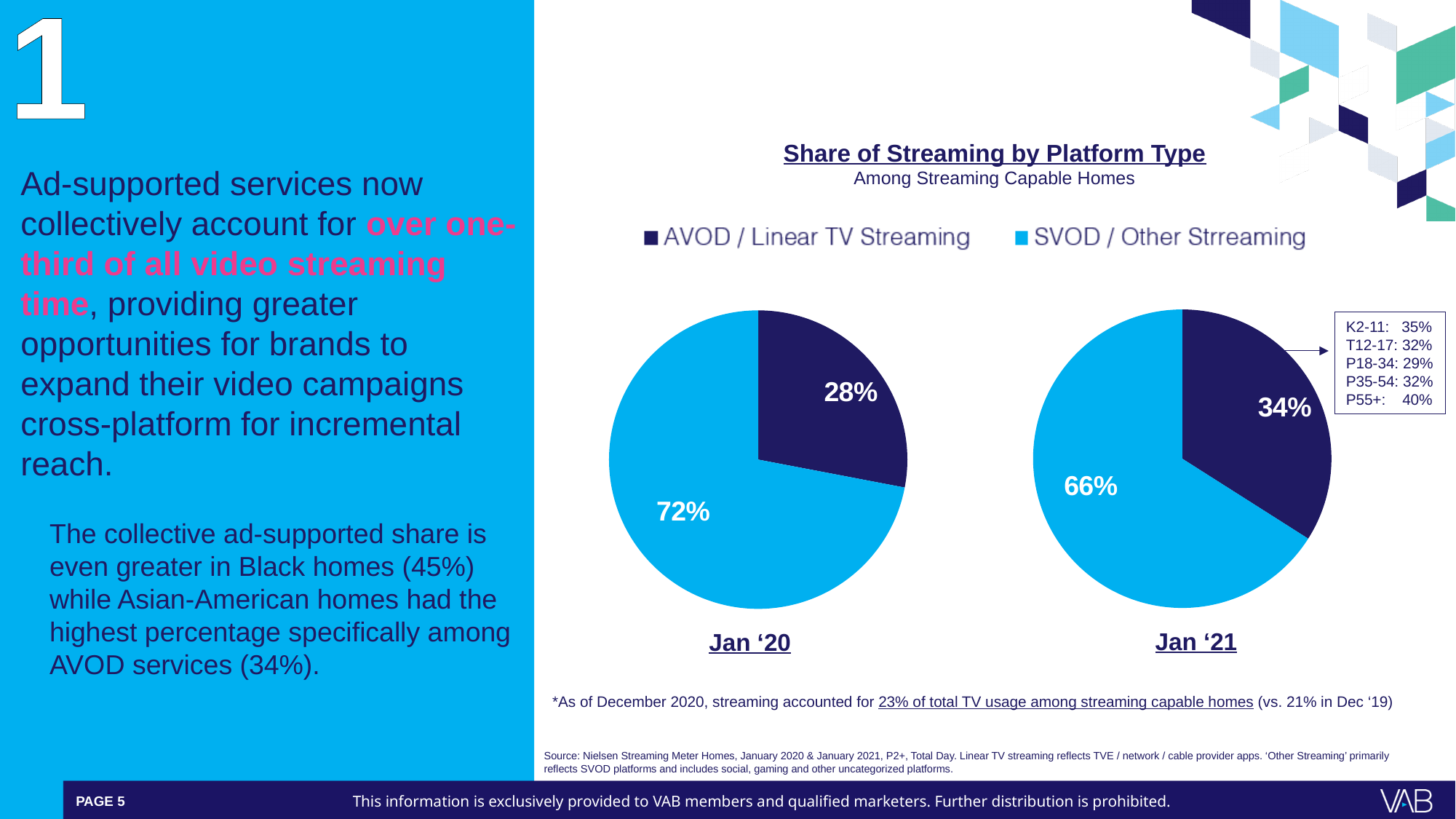
How many series does the legend list for the pie charts? 2 Is the SVOD / Other Streaming share larger in the Jan '20 pie chart or the Jan '21 pie chart? Jan '20 In the Jan '20 pie chart, what is the difference between the SVOD / Other Streaming share and the AVOD / Linear TV Streaming share? 44 percentage points In the Jan '21 pie chart, what share does SVOD / Other Streaming have? 66% What type of chart is used to show the share of streaming by platform type? Pie chart What is the title of the chart on the slide? Share of Streaming by Platform Type In the Jan '20 pie chart, what share does SVOD / Other Streaming have? 72% In the Jan '21 pie chart, what share does AVOD / Linear TV Streaming have? 34% By how many percentage points did the AVOD / Linear TV Streaming share increase from the Jan '20 pie chart to the Jan '21 pie chart? 6 percentage points In the Jan '21 pie chart, which platform type has the larger share? SVOD / Other Streaming In the Jan '20 pie chart, which platform type has the smaller share? AVOD / Linear TV Streaming In the Jan '20 pie chart, what share does AVOD / Linear TV Streaming have? 28%